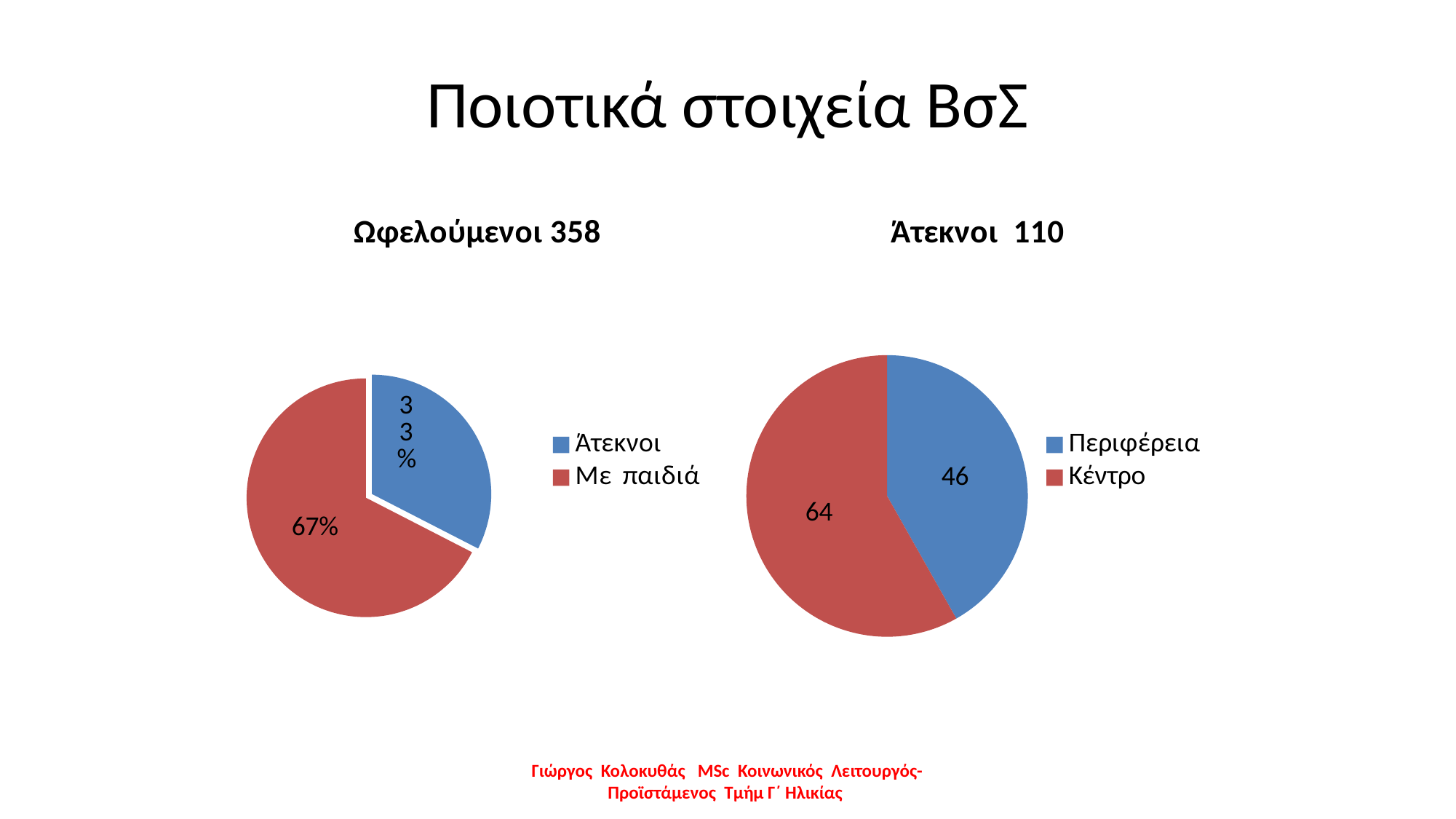
How many entries does the legend of the 'Ωφελούμενοι 358' chart list? 2 In the 'Άτεκνοι 110' chart on the right, what value is shown for Περιφέρεια? 46 In the 'Άτεκνοι 110' chart on the right, what value is shown for Κέντρο? 64 In the 'Άτεκνοι 110' chart, which colour represents Κέντρο? red What kind of chart is the 'Ωφελούμενοι 358' chart on the left? pie chart In the 'Άτεκνοι 110' chart, what is the difference between Κέντρο and Περιφέρεια? 18 In the 'Ωφελούμενοι 358' chart, what percentage is shown for Άτεκνοι? 33% In the 'Ωφελούμενοι 358' chart, which slice is larger, Άτεκνοι or Με παιδιά? Με παιδιά In the 'Ωφελούμενοι 358' chart, what is the difference in percentage points between Με παιδιά and Άτεκνοι? 34 In the 'Άτεκνοι 110' chart, what is the total of the two slices? 110 In the 'Άτεκνοι 110' chart, which category has the highest value? Κέντρο In the 'Ωφελούμενοι 358' chart, what percentage is shown for Με παιδιά? 67%